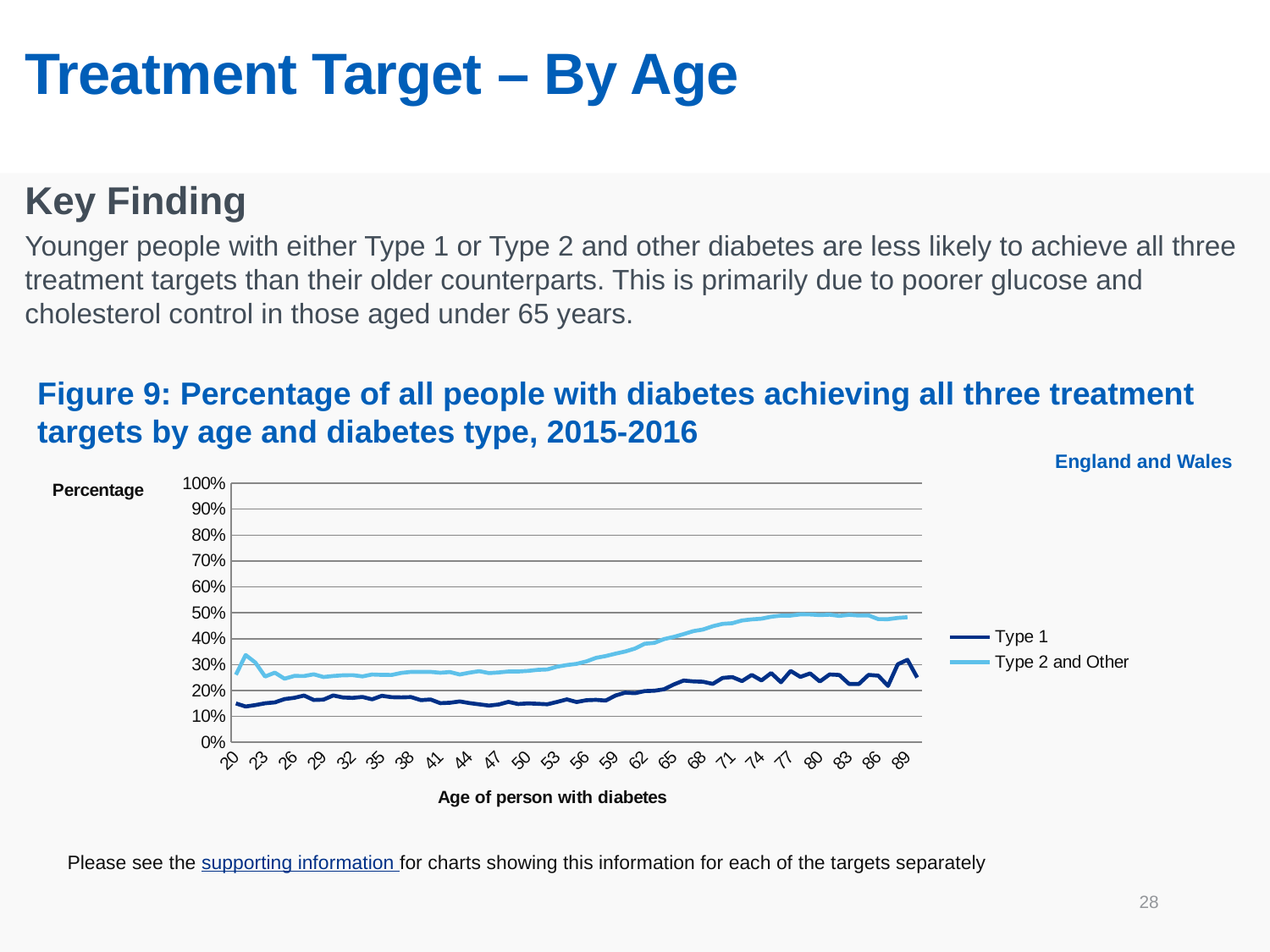
At age 80, which series has the higher value, Type 1 or Type 2 and Other? Type 2 and Other Is the value for Type 2 and Other at age 71 greater or less than 40%? greater What are the two series named in the legend of Figure 9? Type 1; Type 2 and Other What kind of chart is shown in Figure 9? line chart Is the value for Type 2 and Other at age 65 greater or less than 30%? greater What is the label of the x axis in Figure 9? Age of person with diabetes Is the value for Type 2 and Other at age 50 greater or less than 20%? greater At age 50, which series has the higher value, Type 1 or Type 2 and Other? Type 2 and Other How many series does the legend of Figure 9 list? 2 Does the Type 2 and Other line rise or fall between age 50 and age 77? rise